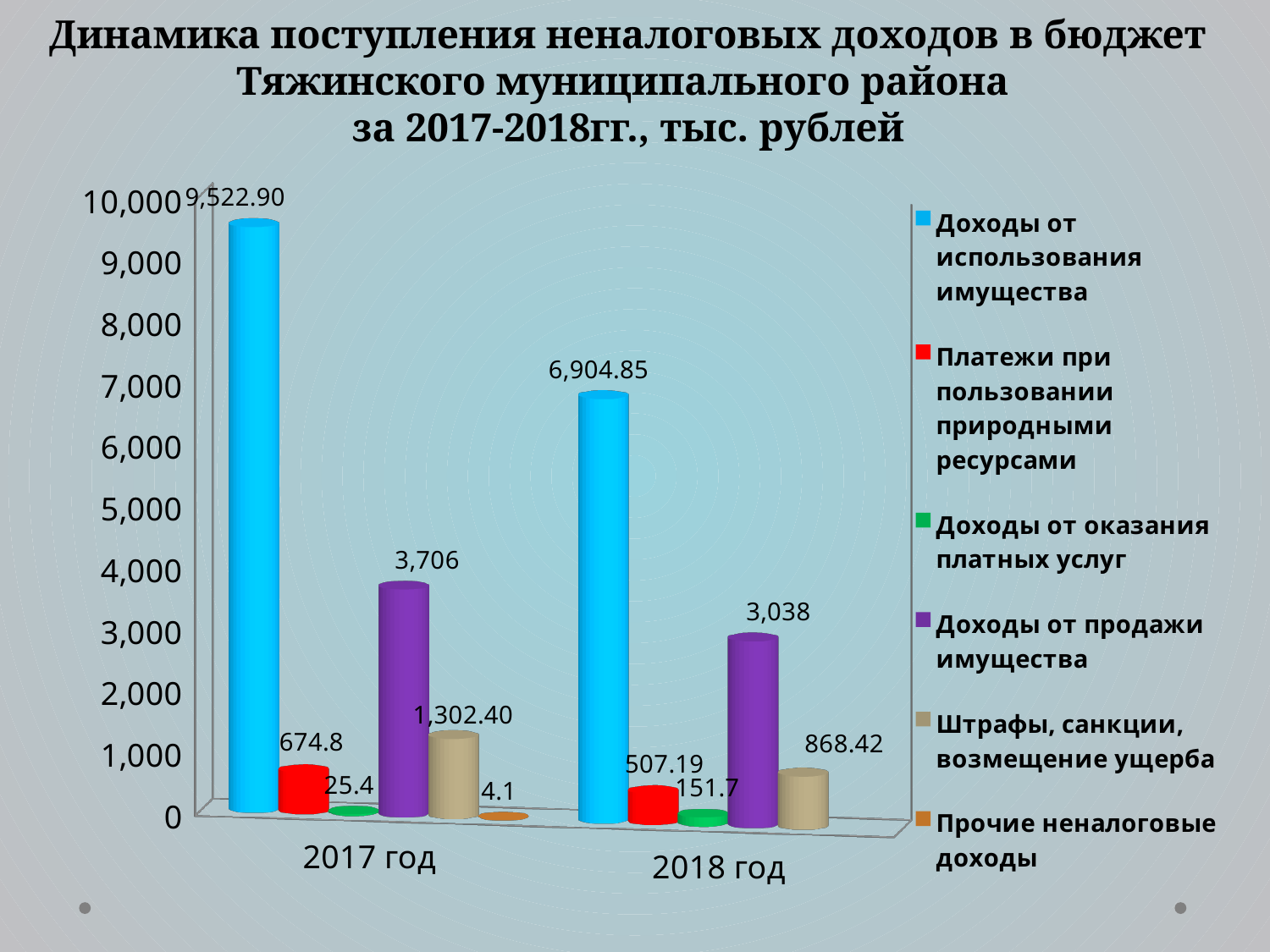
What is the difference between the Доходы от использования имущества values for 2017 год and 2018 год? 2,618.05 What is the value for Доходы от оказания платных услуг in 2018 год? 151.7 Which series has the highest value in 2018 год? Доходы от использования имущества What is the value for Доходы от использования имущества in 2017 год? 9,522.90 What kind of chart is shown on the slide? Bar chart How many series does the legend list? 6 Which series has the lowest value in 2017 год? Прочие неналоговые доходы Which is larger: Платежи при пользовании природными ресурсами in 2017 год or in 2018 год? 2017 год What is the difference between the Доходы от продажи имущества values for 2017 год and 2018 год? 668 What is the value for Штрафы, санкции, возмещение ущерба in 2017 год? 1,302.40 What is the value for Доходы от продажи имущества in 2018 год? 3,038 Does the value for Доходы от оказания платных услуг rise or fall from 2017 год to 2018 год? Rise